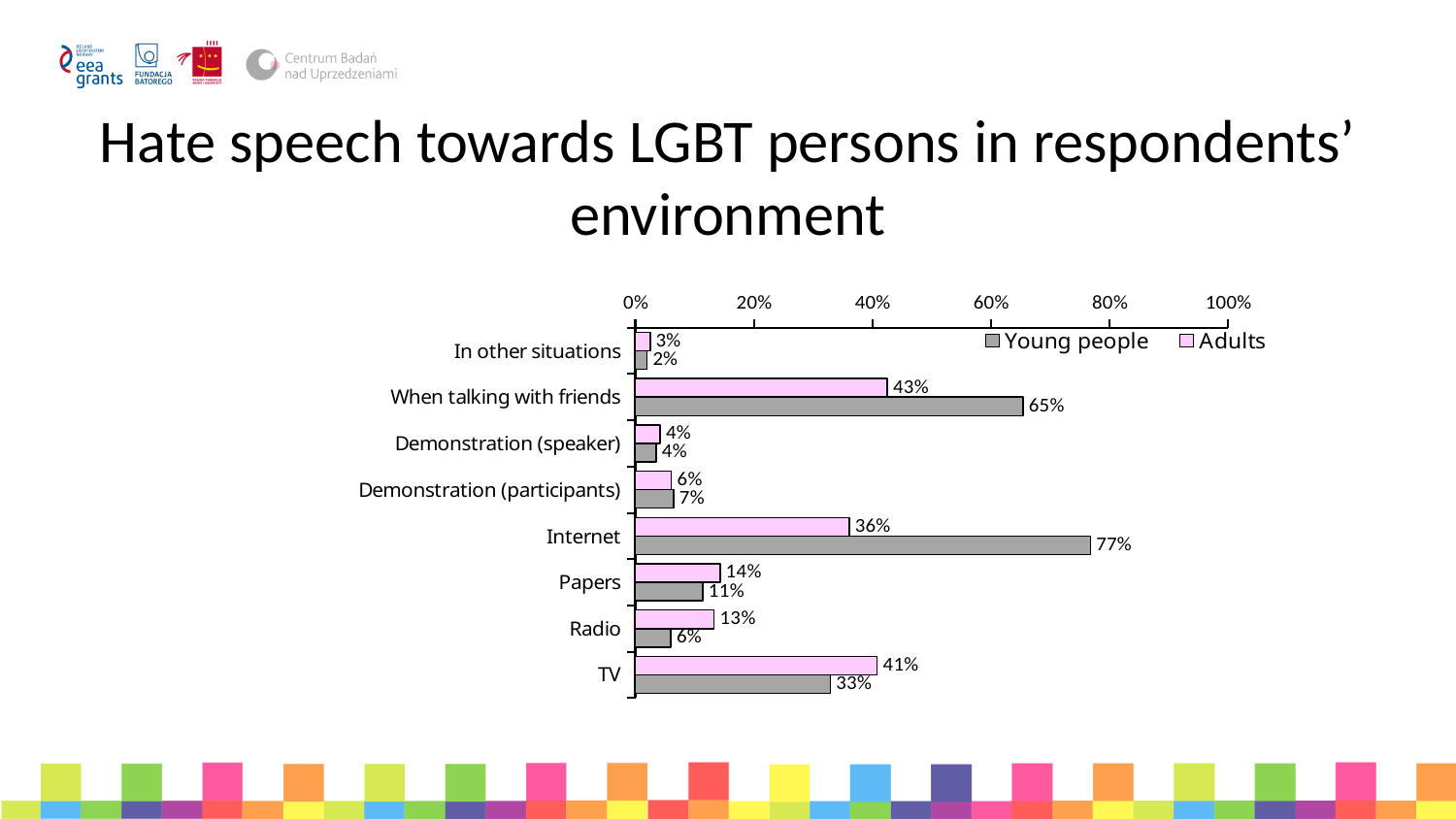
What is the value for adults in the Papers category? 14% Which group has the larger value for Radio, young people or adults? Adults Which category has the lowest value for young people? In other situations How many series does the legend list? 2 Which series is shown in pink in the legend? Adults How many categories are shown on the chart? 8 What percentage of adults reported hate speech towards LGBT persons on TV? 41% What percentage of young people reported hate speech towards LGBT persons on the Internet? 77% Which category has the highest value for young people? Internet What is the value for young people in the 'When talking with friends' category? 65% What is the difference between young people and adults for the Internet category? 41% What kind of chart is shown on the slide? Bar chart